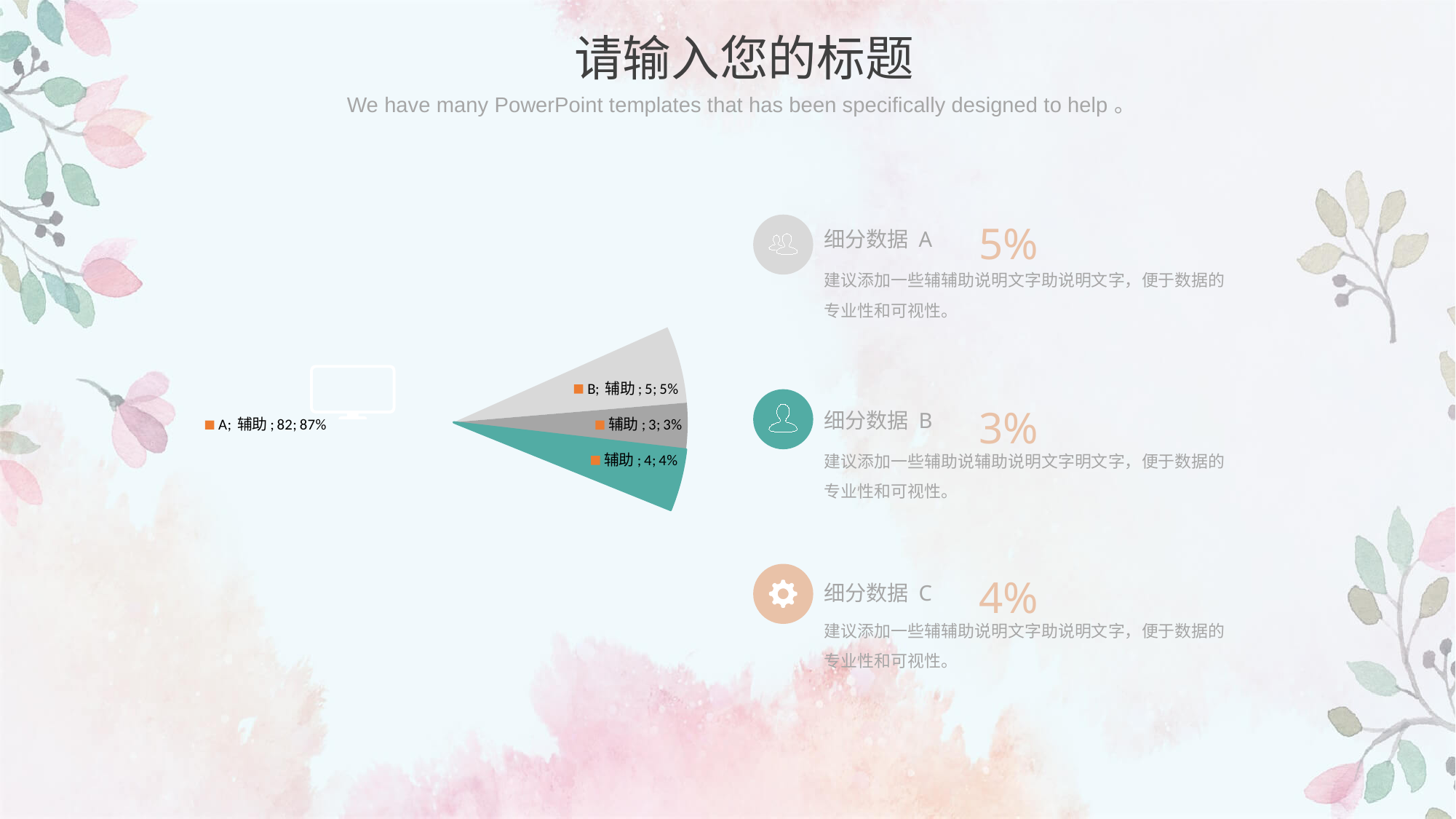
What value is labelled on the teal slice of the pie chart? 4 What value is shown for category A in the pie chart? 82 What value is labelled on the dark grey slice of the pie chart? 3 What is the difference between the values for A and B in the pie chart? 77 What is the smallest value labelled on any slice of the pie chart? 3 What kind of chart is shown on the slide? pie chart What share of the pie does category B represent? 5% What percentage is labelled on the teal slice of the pie chart? 4% What value is shown for category B in the pie chart? 5 What share of the pie does category A represent? 87% Which category has the largest value in the pie chart? A